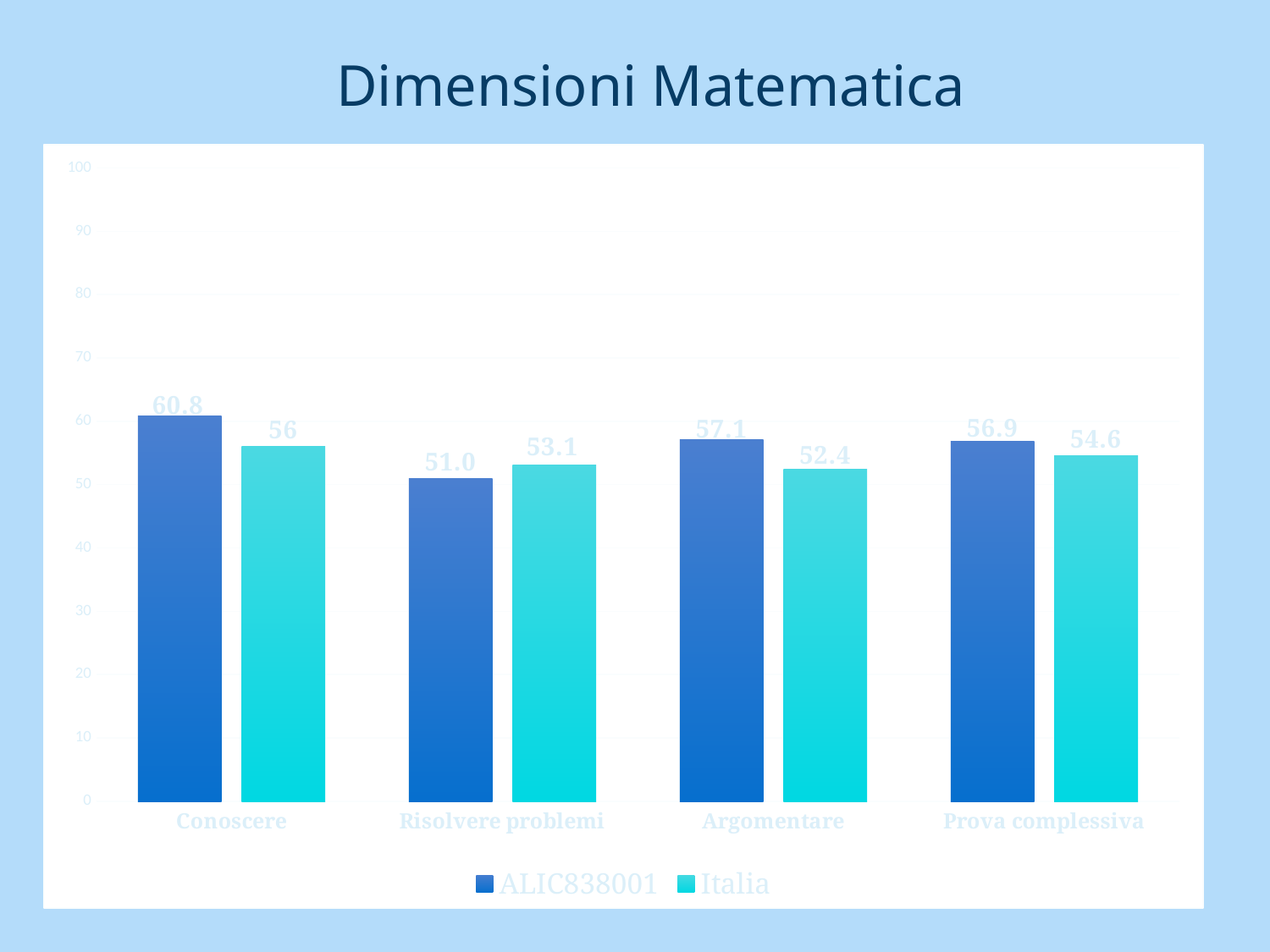
In which category does ALIC838001 have its lowest value? Risolvere problemi How many categories are shown on the x axis? 4 What is the value for Italia in the Argomentare category? 52.4 Is the value for ALIC838001 in Argomentare greater or less than 50? greater In which category does ALIC838001 have its highest value? Conoscere Which is larger in the Risolvere problemi category, ALIC838001 or Italia? Italia What is the value for ALIC838001 in the Conoscere category? 60.8 What is the value for Italia in the Risolvere problemi category? 53.1 What kind of chart is shown on the slide? bar chart What is the difference between the ALIC838001 and Italia values in the Conoscere category? 4.8 How many series does the legend list? 2 What is the value for ALIC838001 in the Prova complessiva category? 56.9